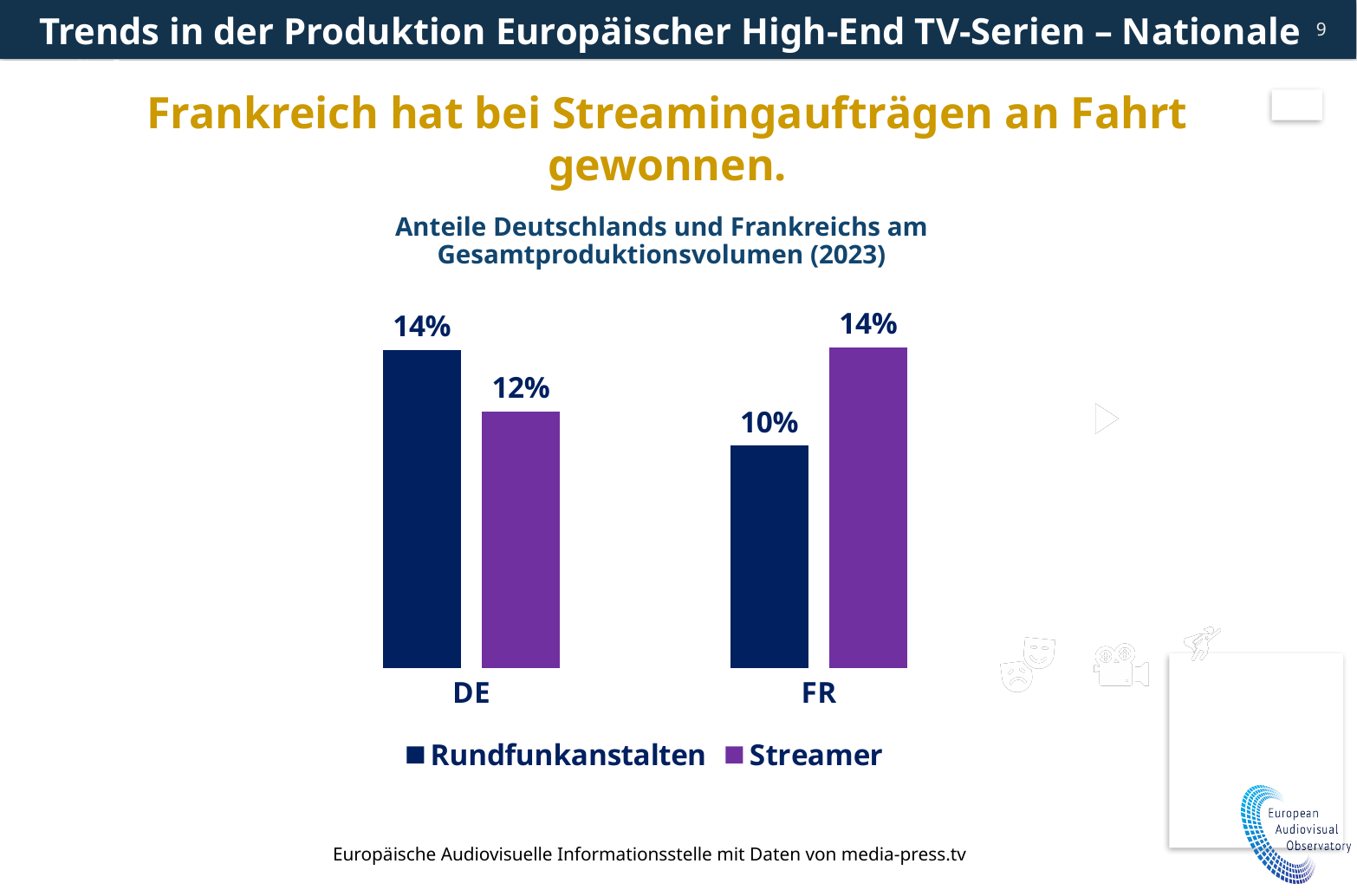
For DE, which is larger: Rundfunkanstalten or Streamer? Rundfunkanstalten What kind of chart is shown on the slide? Bar chart What is the difference between the Rundfunkanstalten and Streamer values for FR? 4% What is the difference between the Rundfunkanstalten and Streamer values for DE? 2% What is the Streamer value for DE? 12% What is the Rundfunkanstalten value for DE? 14% What is the Rundfunkanstalten value for FR? 10% How many categories are shown on the x axis? 2 How many series does the legend list? 2 Which category has the highest Streamer value? FR Which category has the lowest Rundfunkanstalten value? FR What is the Streamer value for FR? 14%